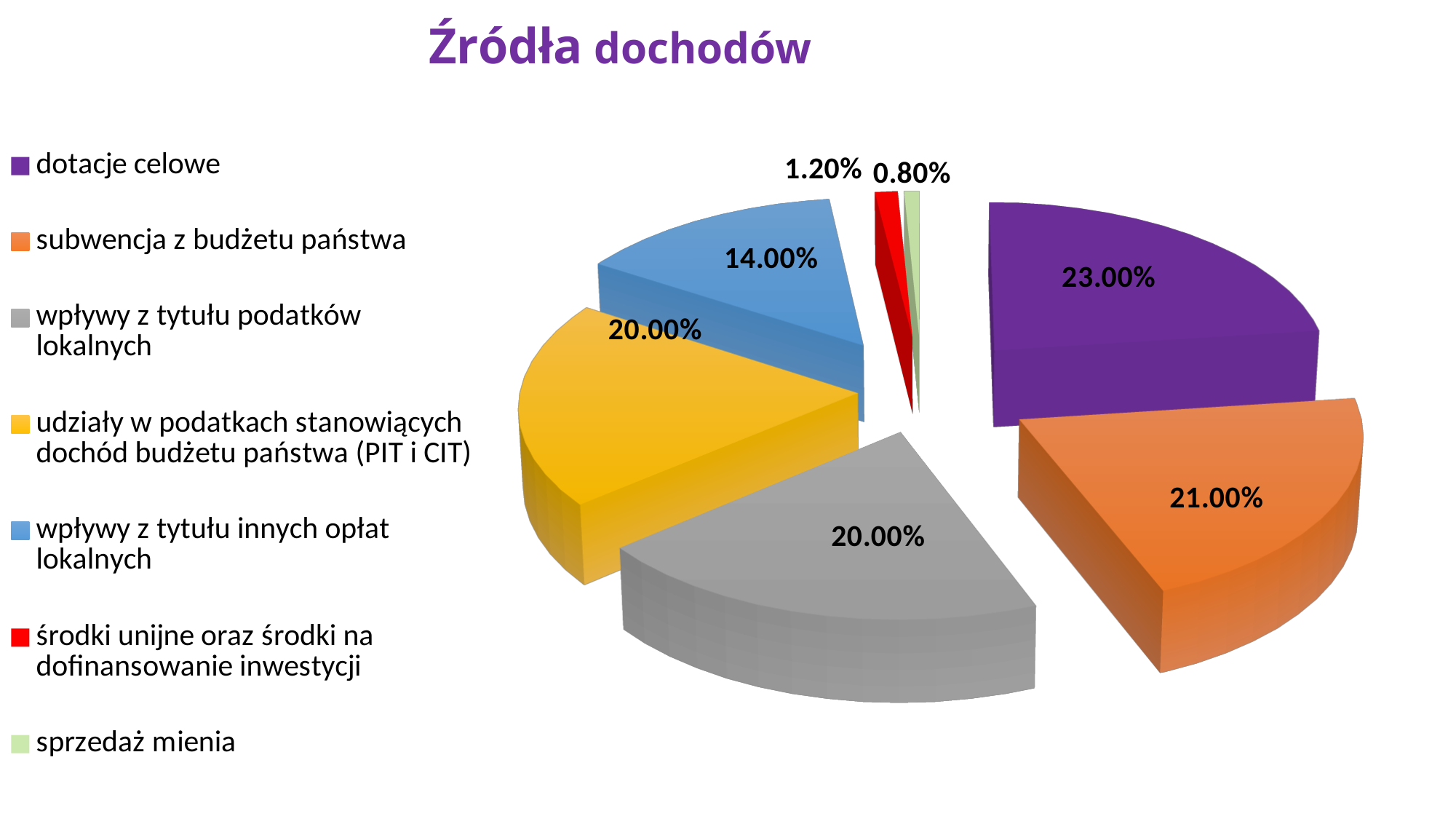
How many categories does the legend list? 7 Which is larger: the share of 'wpływy z tytułu podatków lokalnych' or 'wpływy z tytułu innych opłat lokalnych'? wpływy z tytułu podatków lokalnych What is the difference between the shares of 'dotacje celowe' and 'subwencja z budżetu państwa'? 2.00% What is the value for 'środki unijne oraz środki na dofinansowanie inwestycji'? 1.20% What kind of chart is shown on the slide? pie chart What is the value for 'sprzedaż mienia'? 0.80% Which category has the largest share of the pie? dotacje celowe What share does 'dotacje celowe' have in the pie? 23.00% What is the title of the chart? Źródła dochodów What share does 'subwencja z budżetu państwa' have? 21.00% What is the value for 'wpływy z tytułu innych opłat lokalnych'? 14.00% Which category has the smallest share of the pie? sprzedaż mienia